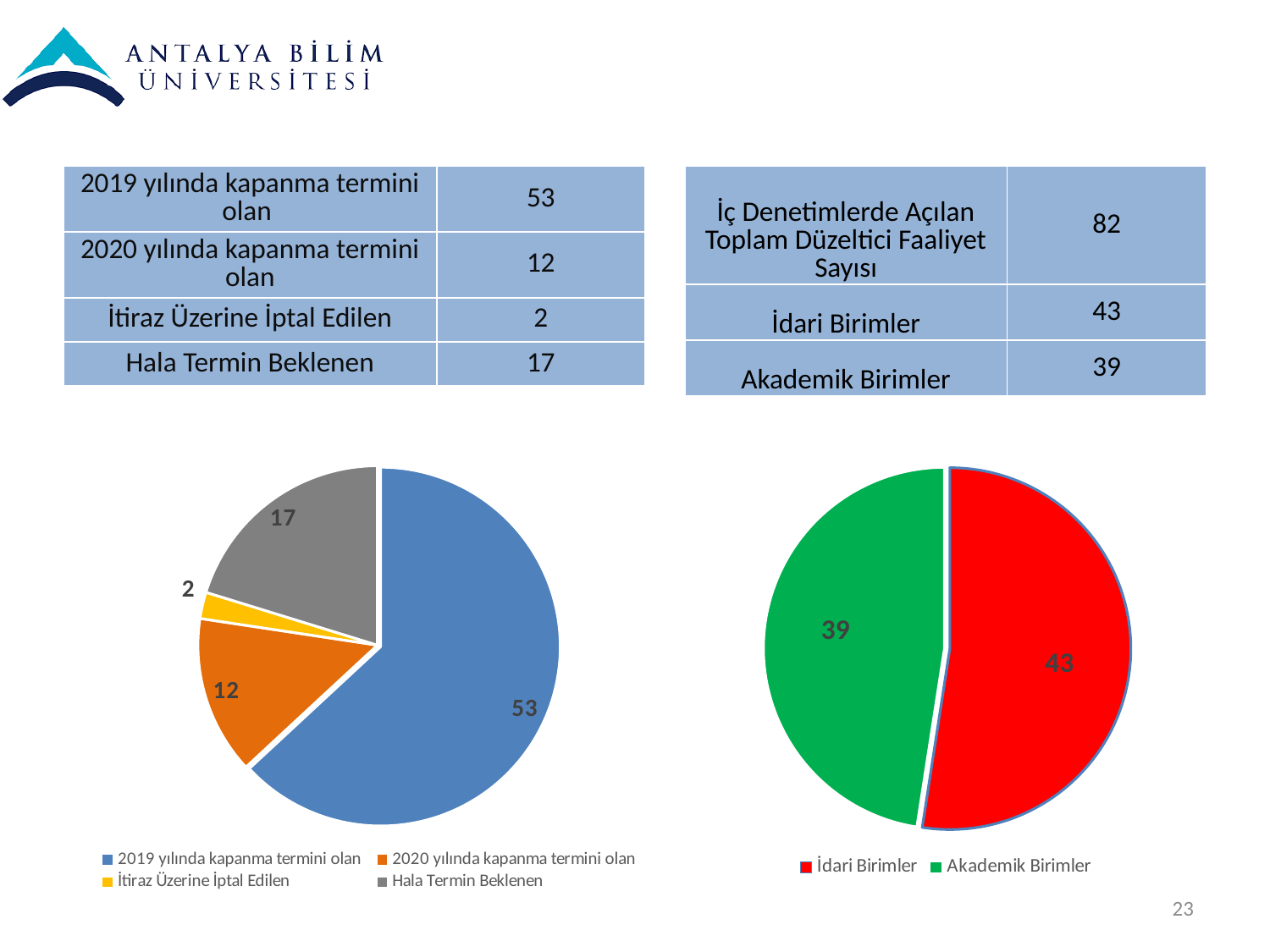
In the left pie chart, what is the value for 'Hala Termin Beklenen'? 17 How many categories does the left pie chart show? 4 In the right pie chart, what is the difference between 'İdari Birimler' and 'Akademik Birimler'? 4 In the left pie chart, what is the difference between '2019 yılında kapanma termini olan' and '2020 yılında kapanma termini olan'? 41 In the left pie chart, which category has the largest slice? 2019 yılında kapanma termini olan In the right pie chart, what is the total of all slices? 82 In the left pie chart, which category has the smallest slice? İtiraz Üzerine İptal Edilen What type of chart is the right chart on the slide? Pie chart In the right pie chart, what is the value for 'Akademik Birimler'? 39 In the left pie chart, what is the value for '2019 yılında kapanma termini olan'? 53 In the right pie chart, which category is larger, 'İdari Birimler' or 'Akademik Birimler'? İdari Birimler In the right pie chart, what colour is the 'Akademik Birimler' slice? Green